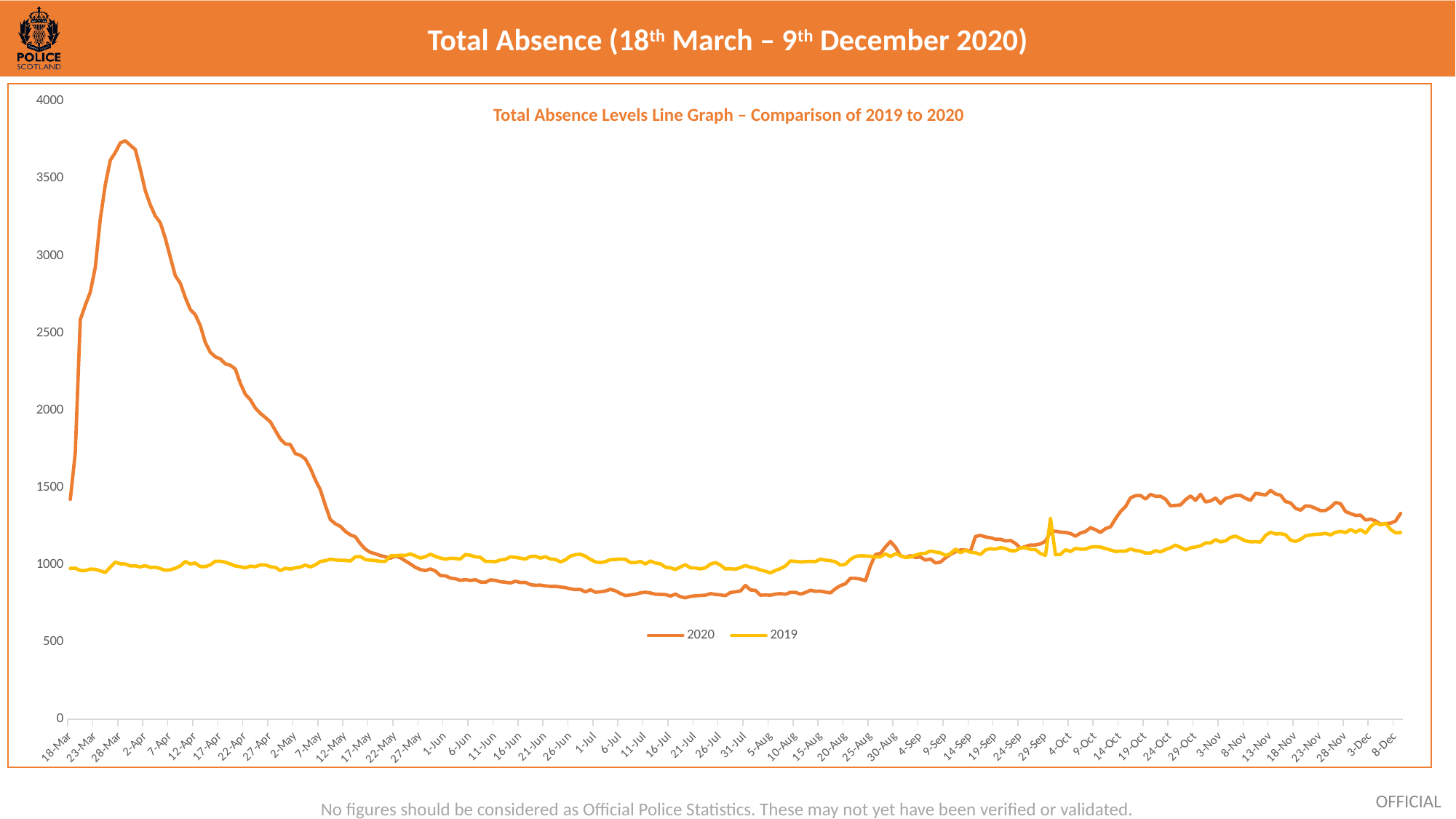
How many series does the legend list? 2 Is the peak value of the 2020 series greater or less than 3500? greater Which series reaches the highest value on the chart? 2020 Is the value for the 2020 series on 2-Apr greater or less than 3000? greater Is the value for the 2019 series on 8-Dec greater or less than 1000? greater What are the two series named in the legend? 2020 and 2019 On 16-Jul, which series has the larger value, 2020 or 2019? 2019 What is the title printed inside the chart area? Total Absence Levels Line Graph – Comparison of 2019 to 2020 What kind of chart is shown on the slide? line chart On 2-Apr, which series has the larger value, 2020 or 2019? 2020 Does the 2020 series rise or fall between 2-Apr and 7-May? fall